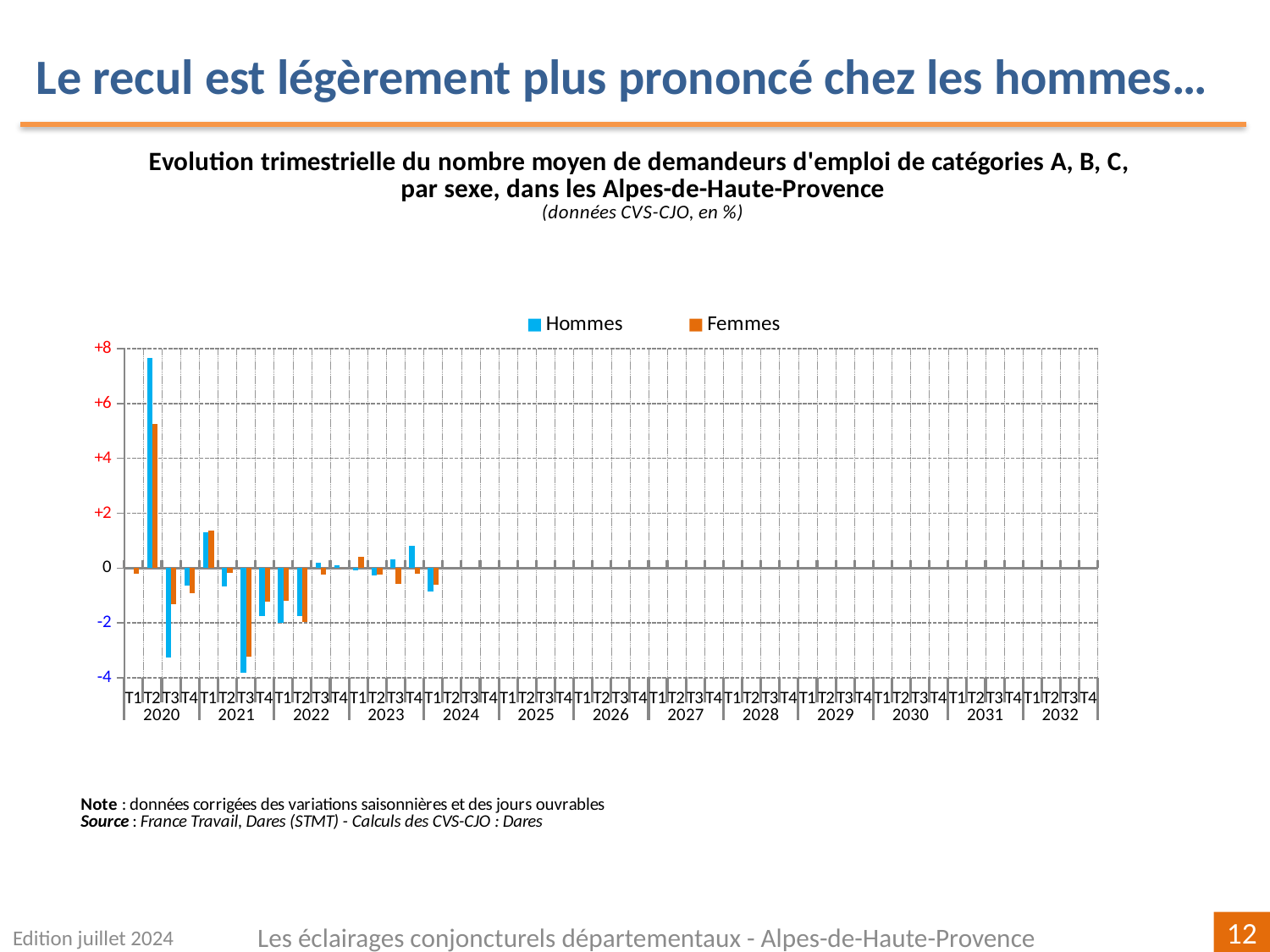
Is the Hommes value for T3 2020 greater or less than -2? less What kind of chart is shown on the slide? Bar chart In which quarter is the Hommes value highest? T2 2020 Which two series are shown in the legend? Hommes and Femmes In which quarter is the Hommes value lowest? T3 2021 In which quarter is the Femmes value highest? T2 2020 Is the Hommes value for T2 2020 greater or less than +6? greater In T3 2020, which series has the lower value, Hommes or Femmes? Hommes Which colour represents the Femmes series? Orange How many series does the legend list? 2 In T2 2020, which series has the larger value, Hommes or Femmes? Hommes Is the Femmes value for T2 2020 greater or less than +4? greater